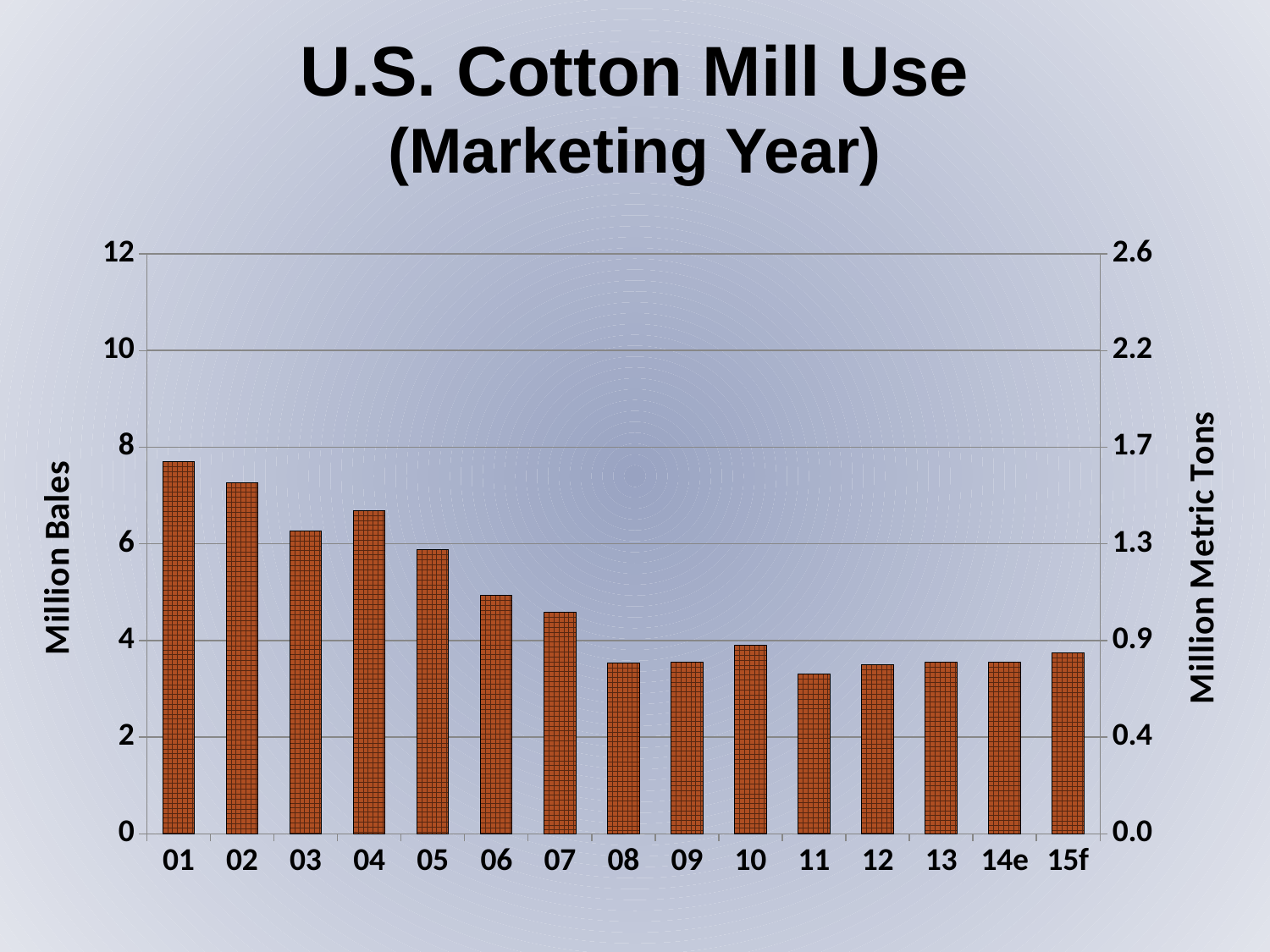
What kind of chart is shown on the slide? bar chart Is the value for 01 greater or less than 6 million bales? greater Is the value for 08 greater or less than 4 million bales? less Is the value for 06 greater or less than 6 million bales? less Overall, do the values rise or fall from 01 to 15f? fall Which marketing year has the highest cotton mill use? 01 Which marketing year has the lowest cotton mill use? 11 Which is larger, the value for 06 or the value for 07? 06 How many marketing years are plotted on the chart? 15 What is the label on the left vertical axis? Million Bales Which is larger, the value for 03 or the value for 04? 04